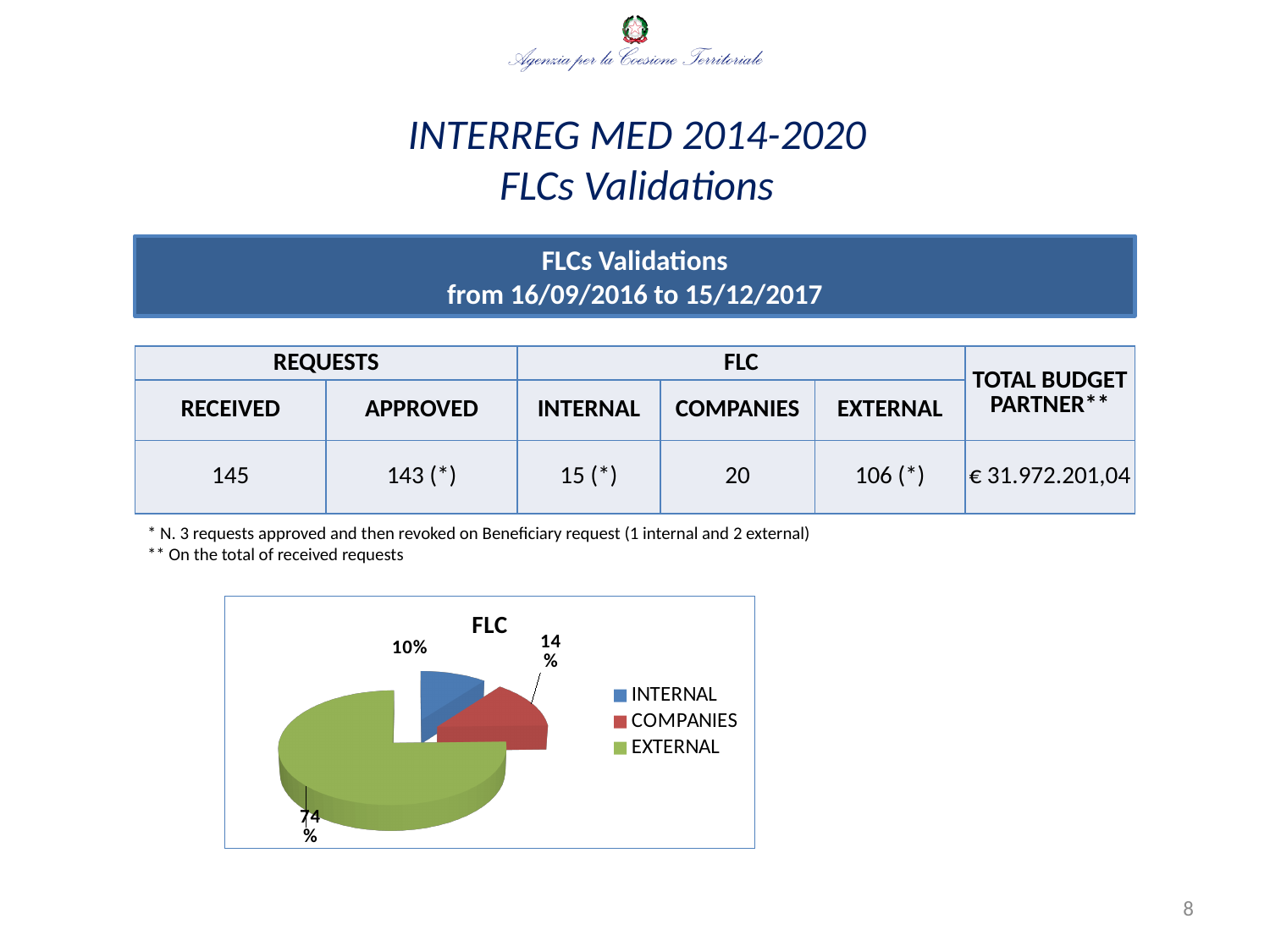
What share of the FLC pie does EXTERNAL represent? 74% Which colour represents EXTERNAL in the FLC pie chart? green What type of chart is shown on the slide? pie chart What share of the FLC pie does COMPANIES represent? 14% Which category has the largest slice in the FLC pie chart? EXTERNAL Which slice is larger in the FLC pie chart, COMPANIES or INTERNAL? COMPANIES What is the difference in percentage points between the EXTERNAL and COMPANIES slices? 60 How many entries does the legend of the FLC chart list? 3 What share of the FLC pie does INTERNAL represent? 10% How many slices does the FLC pie chart have? 3 Which category has the smallest slice in the FLC pie chart? INTERNAL What is the title of the chart? FLC